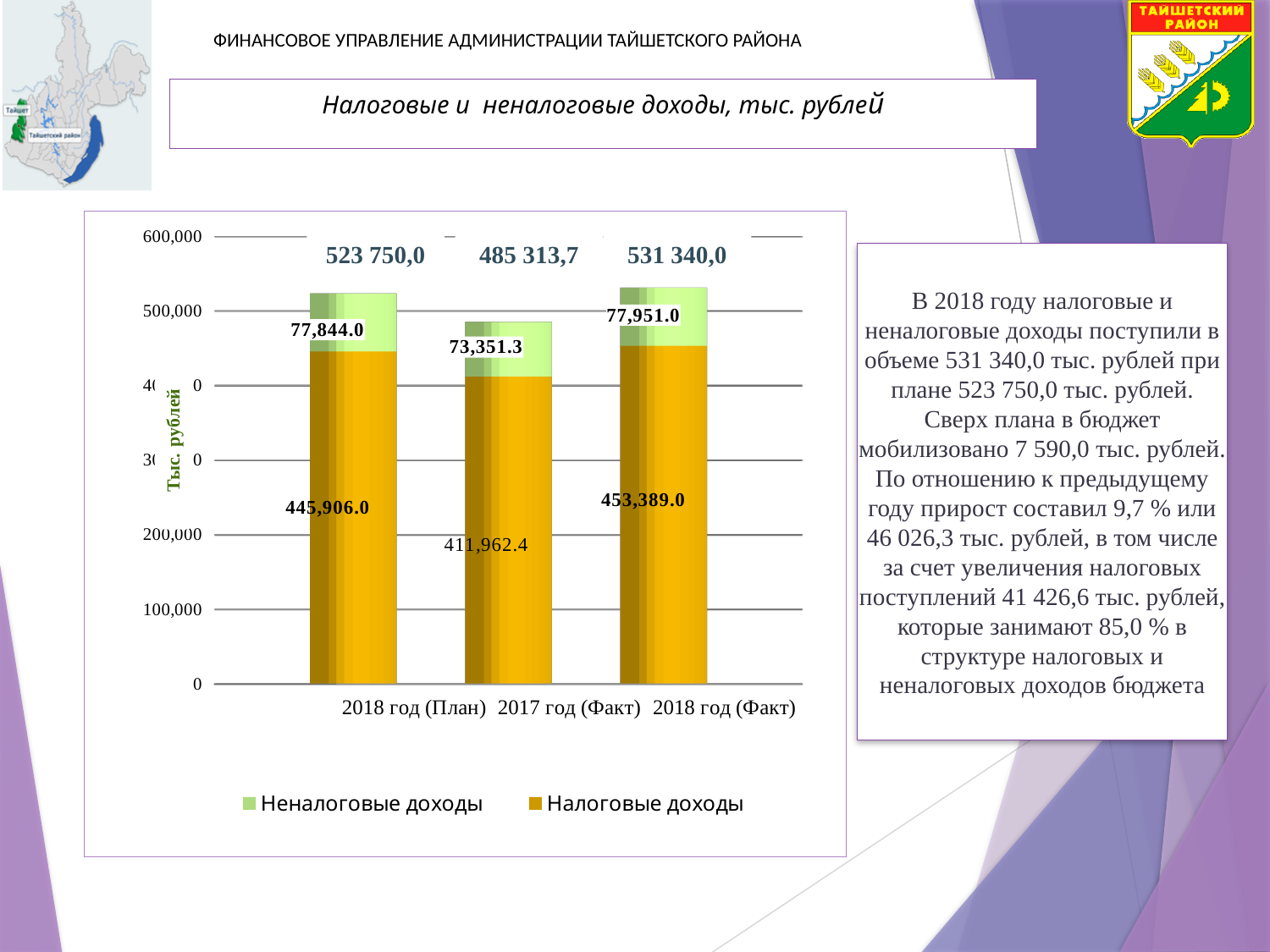
What is the value of Неналоговые доходы for 2018 год (Факт)? 77,951.0 What is the value of Налоговые доходы for 2018 год (План)? 445,906.0 Which category has the highest total? 2018 год (Факт) Which category has the lowest value of Налоговые доходы? 2017 год (Факт) What is the total shown above the bar for 2017 год (Факт)? 485 313,7 What is the value of Налоговые доходы for 2018 год (Факт)? 453,389.0 What is the difference between Налоговые доходы for 2018 год (Факт) and 2017 год (Факт)? 41,426.6 What is the title of the chart? Налоговые и неналоговые доходы, тыс. рублей What is the value of Неналоговые доходы for 2017 год (Факт)? 73,351.3 How many series does the legend list? 2 What is the total shown above the bar for 2018 год (Факт)? 531 340,0 What kind of chart is shown on the slide? Stacked bar chart